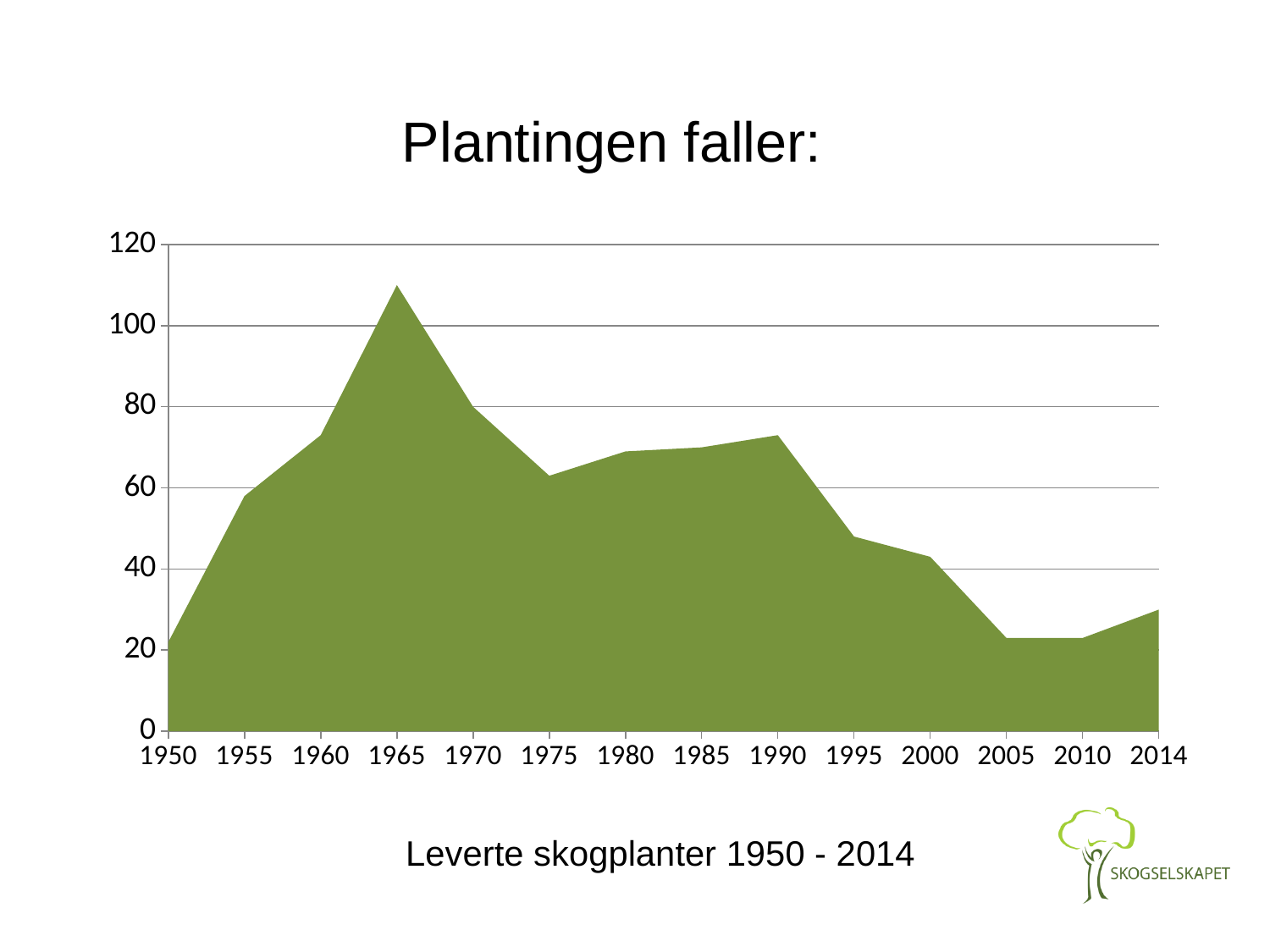
Is the value for 1965 greater or less than 100? greater Which year has the larger value, 1955 or 2000? 1955 Is the value for 1970 greater or less than 60? greater In which year does the chart reach its highest value? 1965 What is the title of the slide above the chart? Plantingen faller: How many years are labelled along the x axis? 14 What caption appears below the chart? Leverte skogplanter 1950 - 2014 Is the value for 2014 greater or less than 40? less Do the values rise or fall between 1990 and 2005? fall What kind of chart is shown on the slide? Area chart Which year has the larger value, 1965 or 1990? 1965